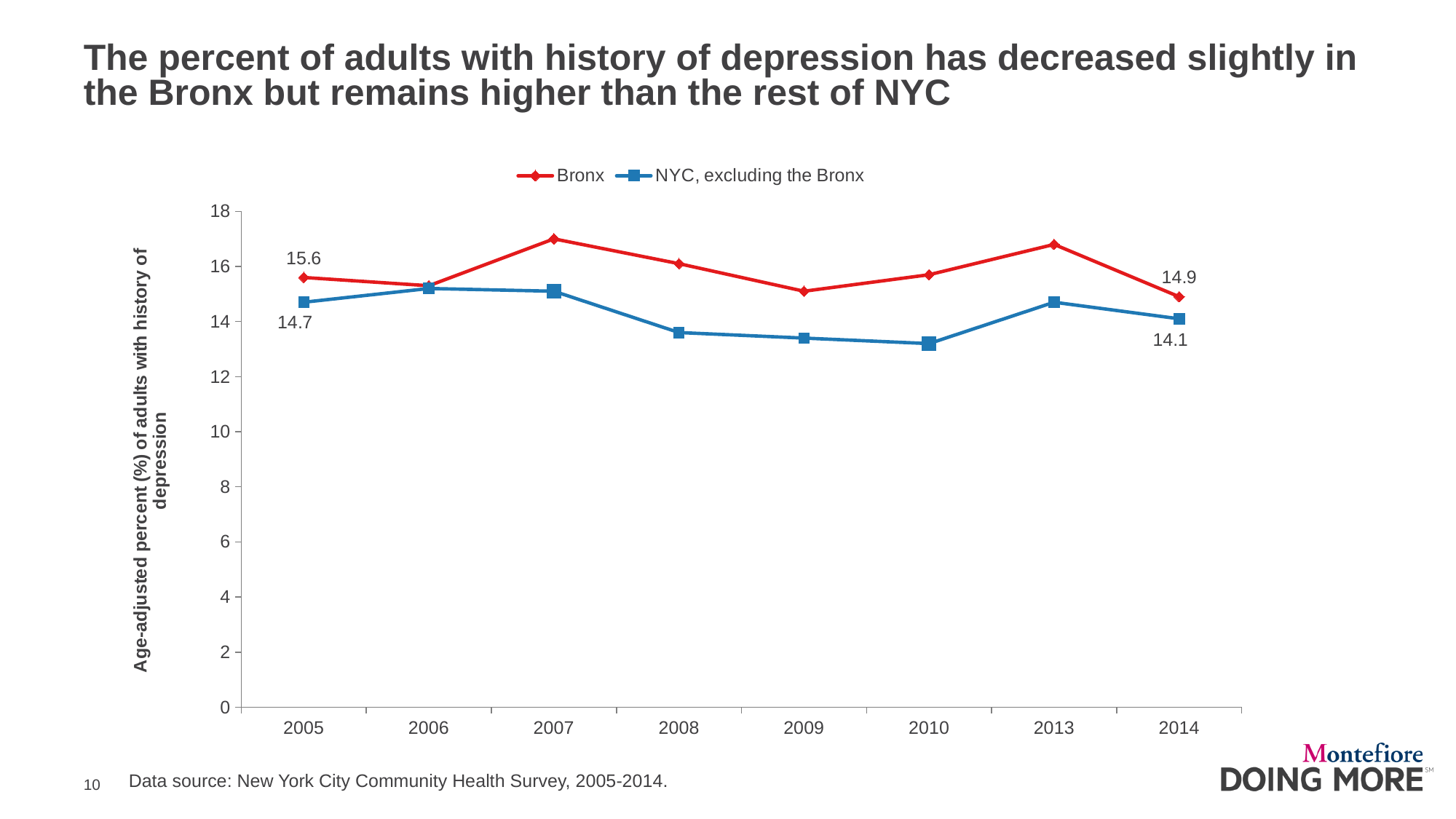
In 2014, which series has the larger value, Bronx or NYC, excluding the Bronx? Bronx In 2014, what is the difference between the Bronx and NYC, excluding the Bronx? 0.8 Is the value for the Bronx in 2007 greater or less than 16? greater What is the difference between the Bronx value in 2005 and in 2014? 0.7 How many series does the legend list? 2 What is the value for the Bronx in 2014? 14.9 What is the value for the Bronx in 2005? 15.6 What is the value for NYC, excluding the Bronx in 2005? 14.7 Is the value for NYC, excluding the Bronx in 2010 greater or less than 14? less What kind of chart is shown on the slide? Line chart What is the value for NYC, excluding the Bronx in 2014? 14.1 How many years are shown on the x axis? 8